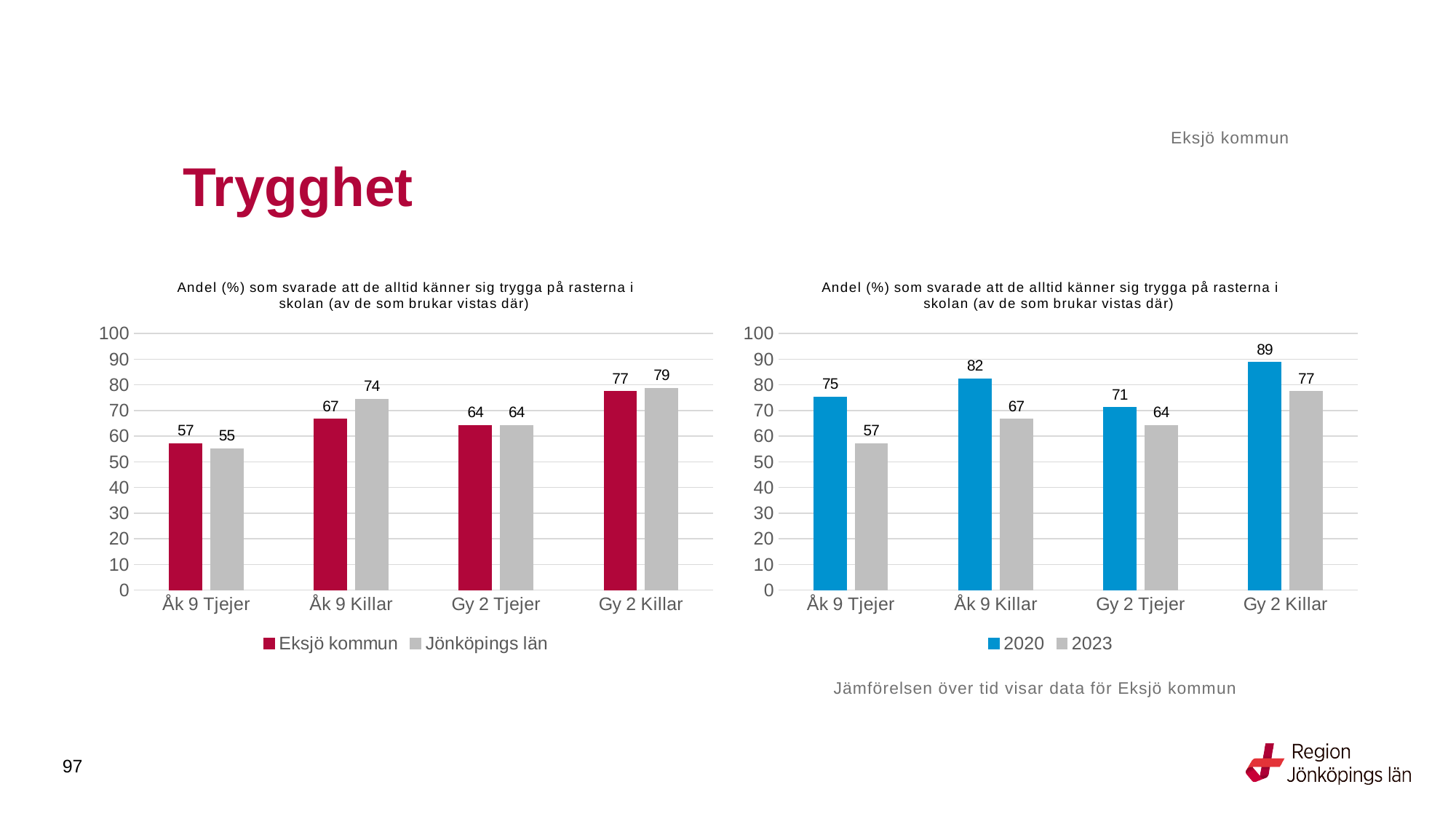
In the right chart, what is the difference between the 2020 and 2023 values for Åk 9 Tjejer? 18 How many series does the legend of the left chart list? 2 In the left chart, what is the value for Eksjö kommun for Åk 9 Tjejer? 57 In the left chart, what is the difference between the Jönköpings län and Eksjö kommun values for Åk 9 Killar? 7 How many categories are shown on the x axis of the right chart? 4 In the right chart, which category has the lowest value for 2023? Åk 9 Tjejer What kind of chart is the right chart? Bar chart In the left chart, which is larger for Gy 2 Killar: Eksjö kommun or Jönköpings län? Jönköpings län In the right chart, what is the value for 2023 for Gy 2 Tjejer? 64 In the left chart, what is the value for Jönköpings län for Åk 9 Killar? 74 In the left chart, which category has the highest value for Eksjö kommun? Gy 2 Killar In the right chart, what is the value for 2020 for Gy 2 Killar? 89